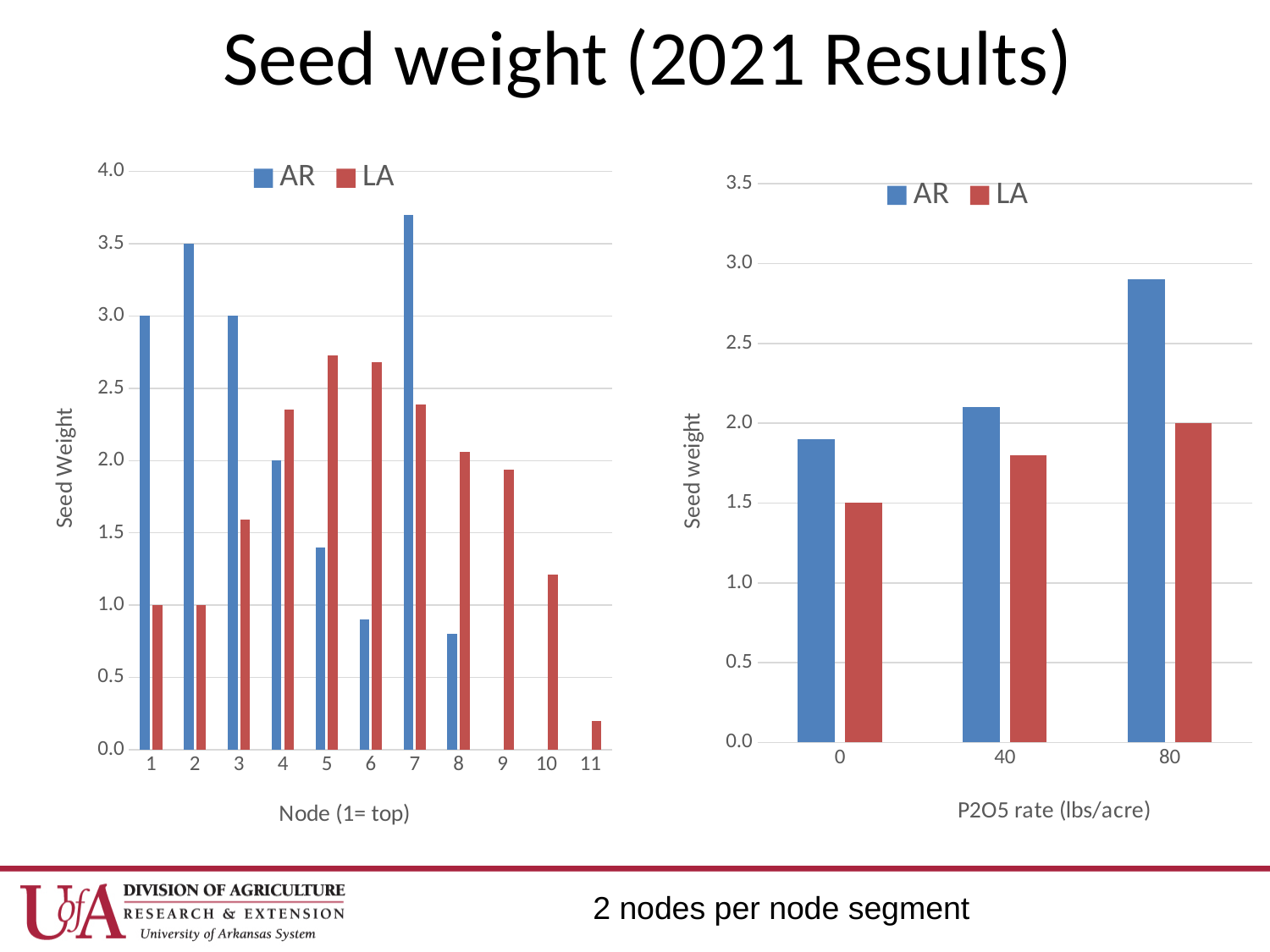
On the right chart (Seed weight by P2O5 rate), how many series does the legend list? 2 On the left chart (Seed Weight by Node), what is the AR value at node 2? 3.5 On the left chart (Seed Weight by Node), is the LA value at node 5 greater or less than 2.5? greater What kind of chart is the right chart (Seed weight by P2O5 rate)? bar chart On the left chart (Seed Weight by Node), which is larger at node 6, AR or LA? LA On the left chart (Seed Weight by Node), at which node is the AR bar highest? 7 On the right chart (Seed weight by P2O5 rate), what is the LA value at a rate of 0? 1.5 On the right chart (Seed weight by P2O5 rate), does the AR seed weight rise or fall as the P2O5 rate increases? rise On the left chart (Seed Weight by Node), at which node is the LA bar lowest? 11 On the left chart (Seed Weight by Node), how many nodes are shown on the x axis? 11 On the left chart (Seed Weight by Node), what is the LA value at node 1? 1.0 On the right chart (Seed weight by P2O5 rate), at which P2O5 rate is the AR bar highest? 80